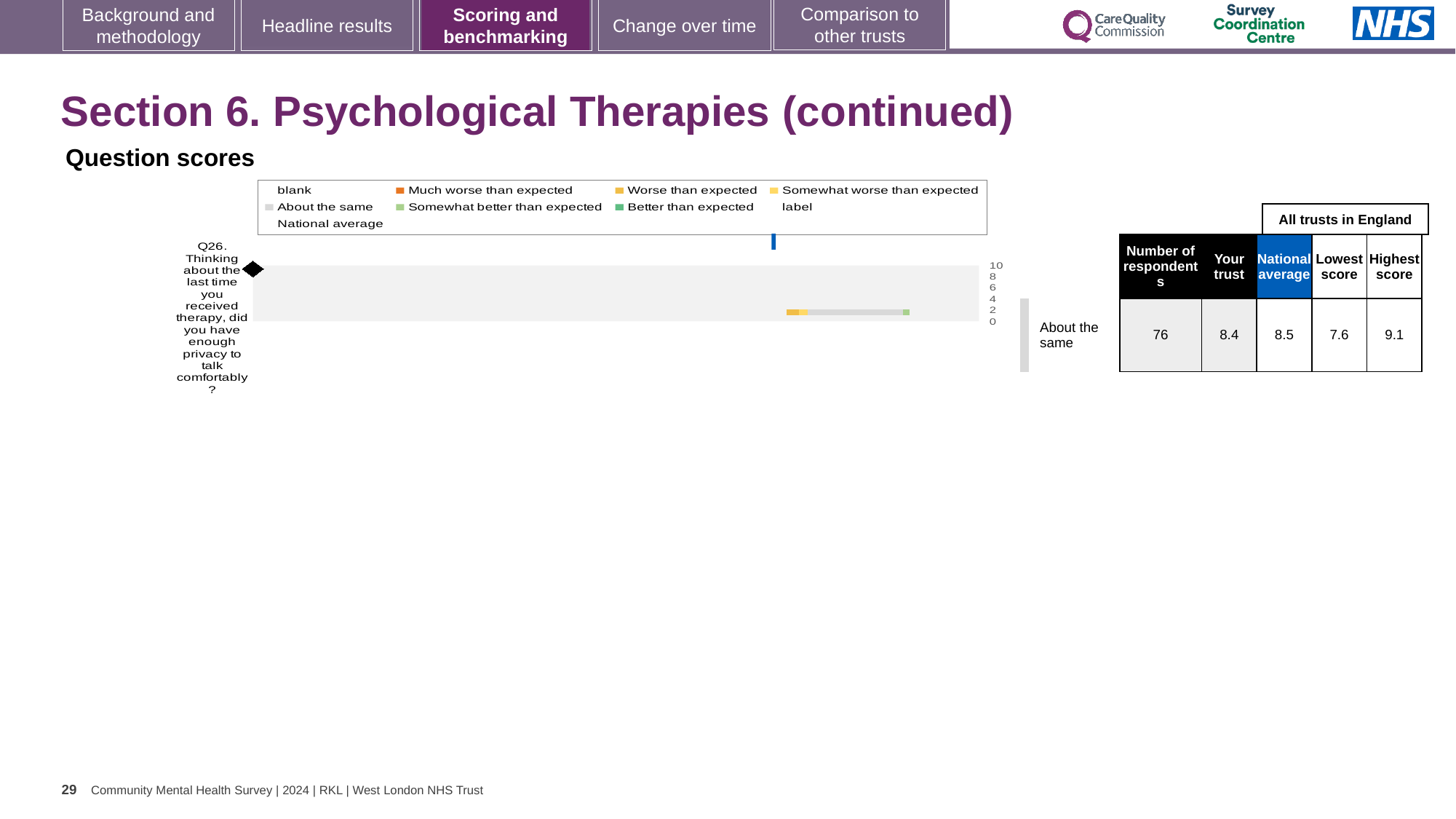
How is the trust's result for Q26 categorised relative to what was expected? About the same What is the lowest score among all trusts in England for Q26? 7.6 What is the national average score shown for Q26? 8.5 How many respondents answered Q26? 76 How many survey questions are plotted on the chart? 1 What is the highest score among all trusts in England for Q26? 9.1 Which is larger for Q26, the trust's score or the national average? National average What is the maximum value shown on the chart's score axis? 10 What is the 'Your trust' score for Q26 about having enough privacy to talk comfortably during therapy? 8.4 What is the difference between the highest and lowest scores for Q26 across all trusts in England? 1.5 What is the difference between the national average and the trust's score for Q26? 0.1 What kind of chart is used to show the question scores? Bar chart